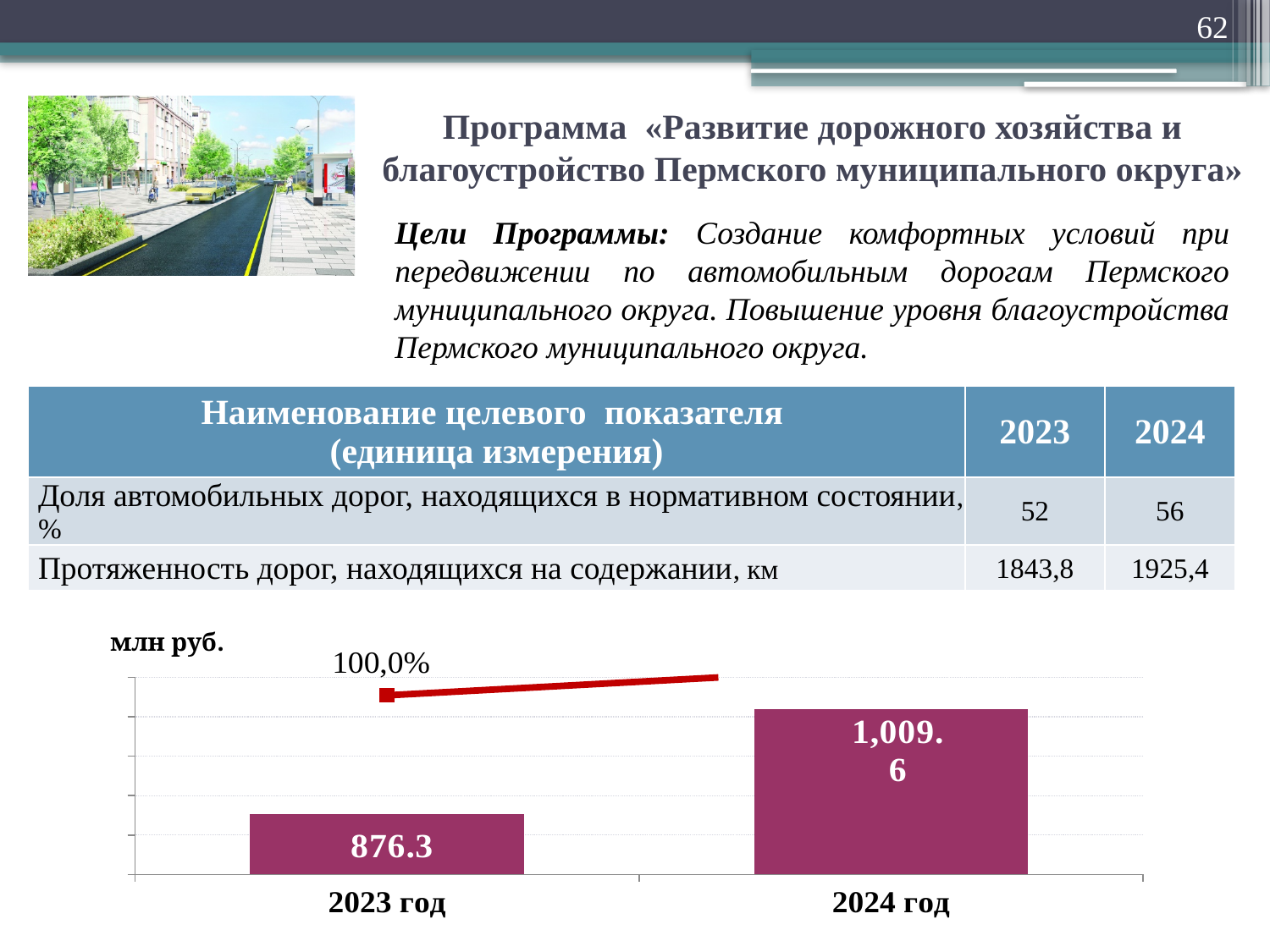
What kind of chart is shown at the bottom of the slide? combination bar and line chart What is the value for 2023 год in the bar chart? 876.3 What is the value for 2024 год in the bar chart? 1,009.6 Do the values in the bar chart rise or fall from 2023 год to 2024 год? rise Which is larger in the bar chart: the value for 2023 год or the value for 2024 год? 2024 год How many bars are shown in the bar chart? 2 Which year has the lowest value in the bar chart? 2023 год What unit is indicated above the bar chart? млн руб. What is the difference between the values for 2024 год and 2023 год in the bar chart? 133.3 What percentage label is shown above the line in the bar chart? 100,0% Which year has the highest value in the bar chart? 2024 год